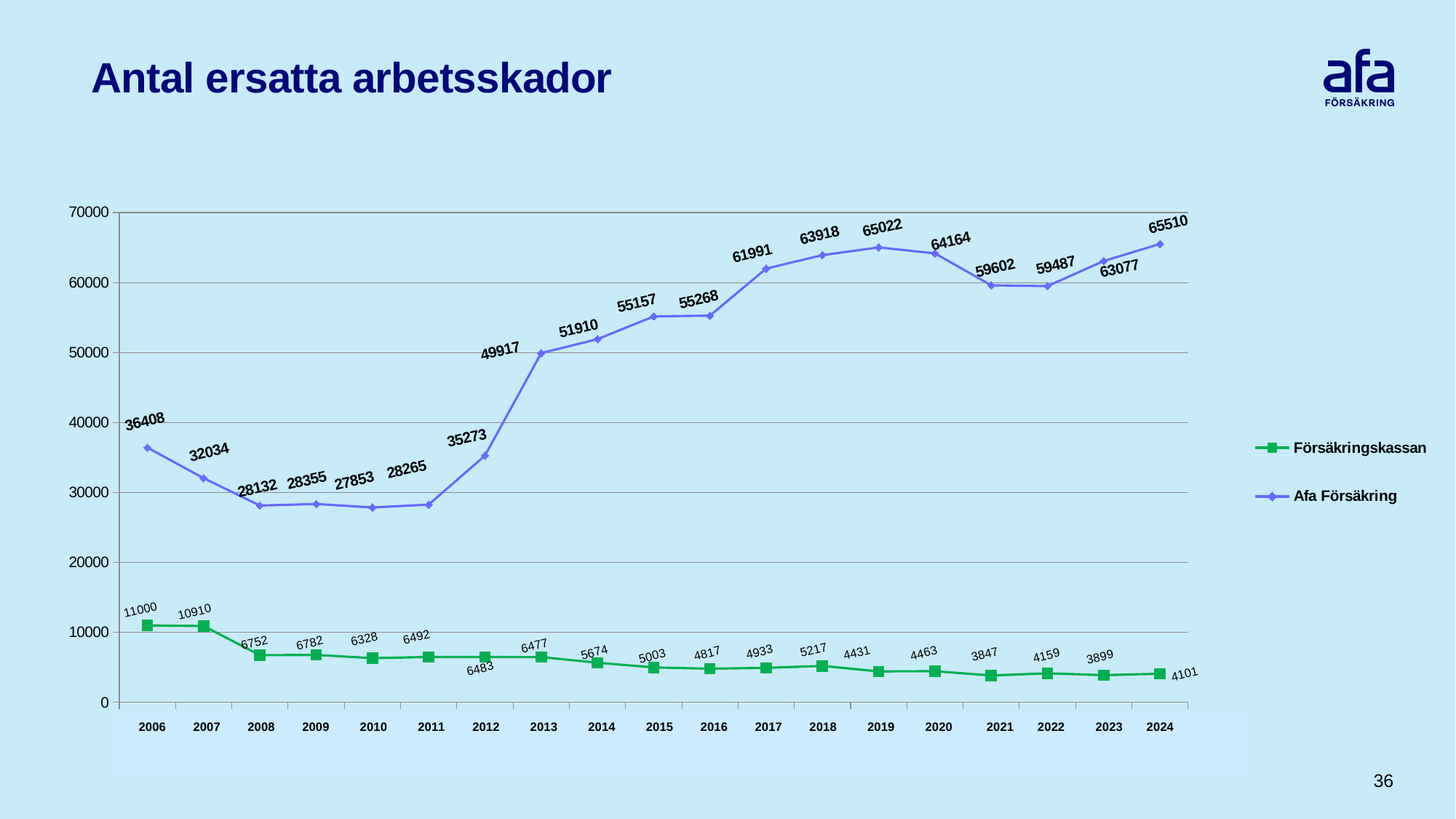
What is the value for Försäkringskassan in 2006? 11000 How many series does the legend list? 2 In which year is the Afa Försäkring value highest? 2024 What is the value for Afa Försäkring in 2013? 49917 Is the Afa Försäkring value for 2012 greater or less than 40000? less Which is larger: the Afa Försäkring value in 2019 or in 2020? 2019 In which year is the Försäkringskassan value lowest? 2021 In which year is the Afa Försäkring value lowest? 2010 How many years are shown on the x axis? 19 What kind of chart is shown on the slide? line chart What is the difference between the Afa Försäkring value and the Försäkringskassan value in 2024? 61409 What is the value for Afa Försäkring in 2024? 65510